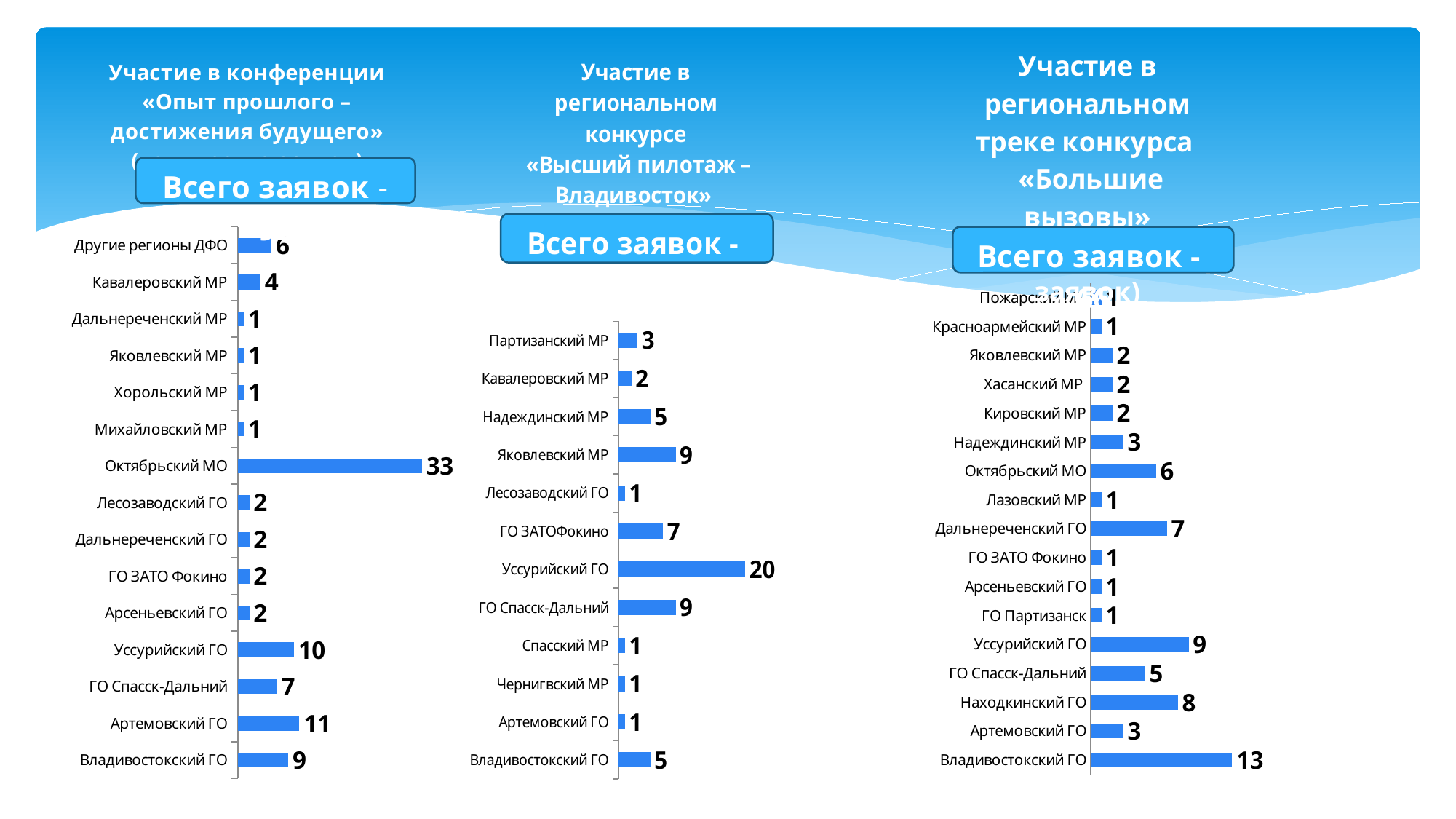
In the right chart, which category has the highest value? Владивостокский ГО In the middle chart, how many categories are plotted? 12 In the left chart, how many categories are plotted? 15 In the middle chart, which is larger: ГО ЗАТОФокино or Надеждинский МР? ГО ЗАТОФокино In the middle chart («Высший пилотаж – Владивосток»), what is the value for Уссурийский ГО? 20 In the left chart (conference «Опыт прошлого – достижения будущего»), what is the value for Октябрьский МО? 33 In the left chart, what is the difference between Артемовский ГО and Владивостокский ГО? 2 In the middle chart, which category has the highest value? Уссурийский ГО What type of chart is used on this slide? Bar chart In the right chart, what is the difference between Уссурийский ГО and Находкинский ГО? 1 In the left chart, which category has the highest value? Октябрьский МО In the right chart («Большие вызовы»), what is the value for Владивостокский ГО? 13